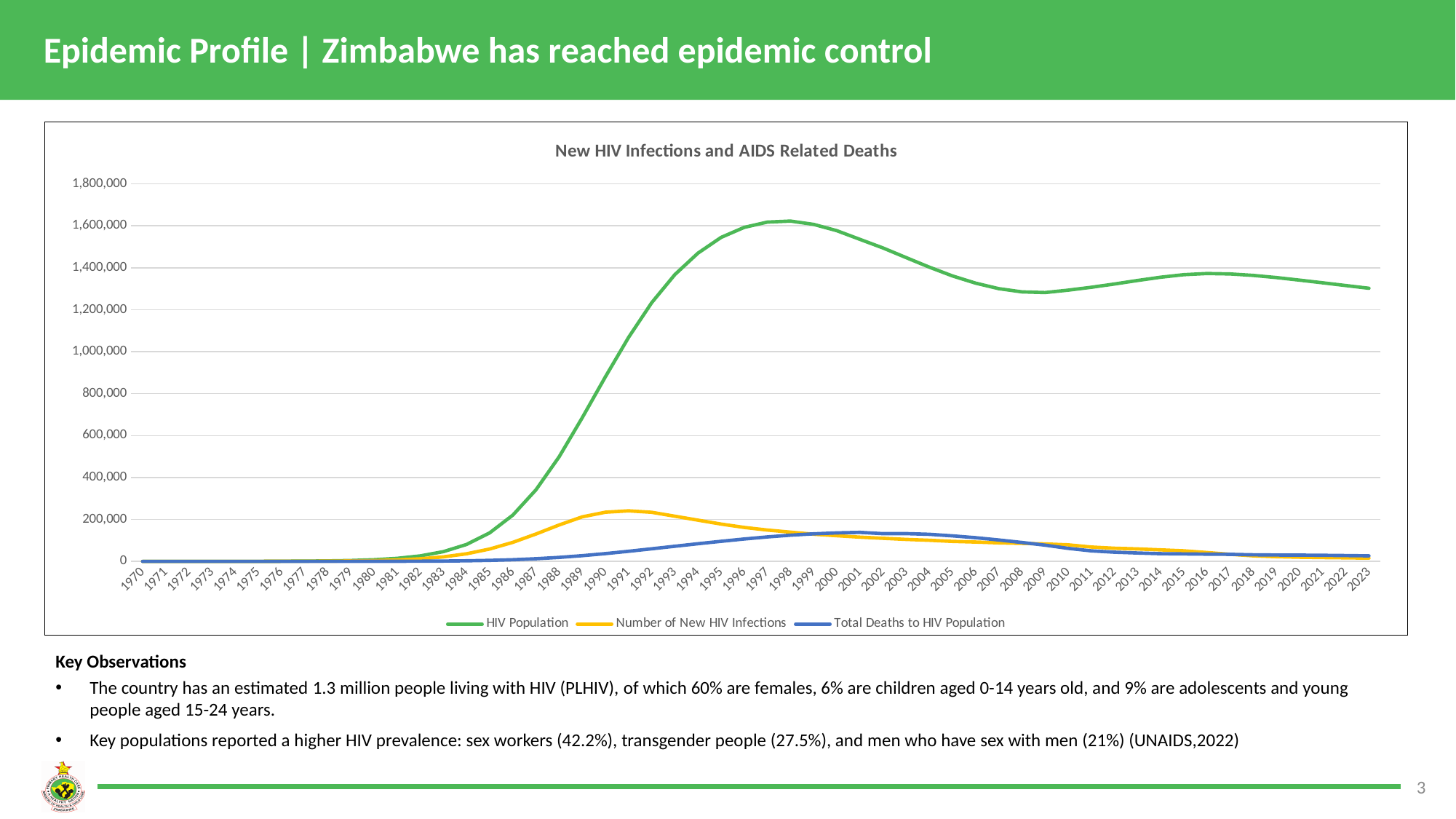
Does the Number of New HIV Infections series rise or fall from 1991 to 2023? fall How many series does the legend list? 3 Is the Number of New HIV Infections value for 1991 greater or less than 200,000? greater Is the HIV Population value for 1992 greater or less than 1,000,000? greater What kind of chart is shown on the slide? line chart What is the title of the chart? New HIV Infections and AIDS Related Deaths How many years are plotted along the x axis? 54 Which series is drawn in green? HIV Population In 1991, which is larger: Number of New HIV Infections or Total Deaths to HIV Population? Number of New HIV Infections Is the Total Deaths to HIV Population value for 2001 greater or less than 200,000? less Which series has the highest value in 2023? HIV Population